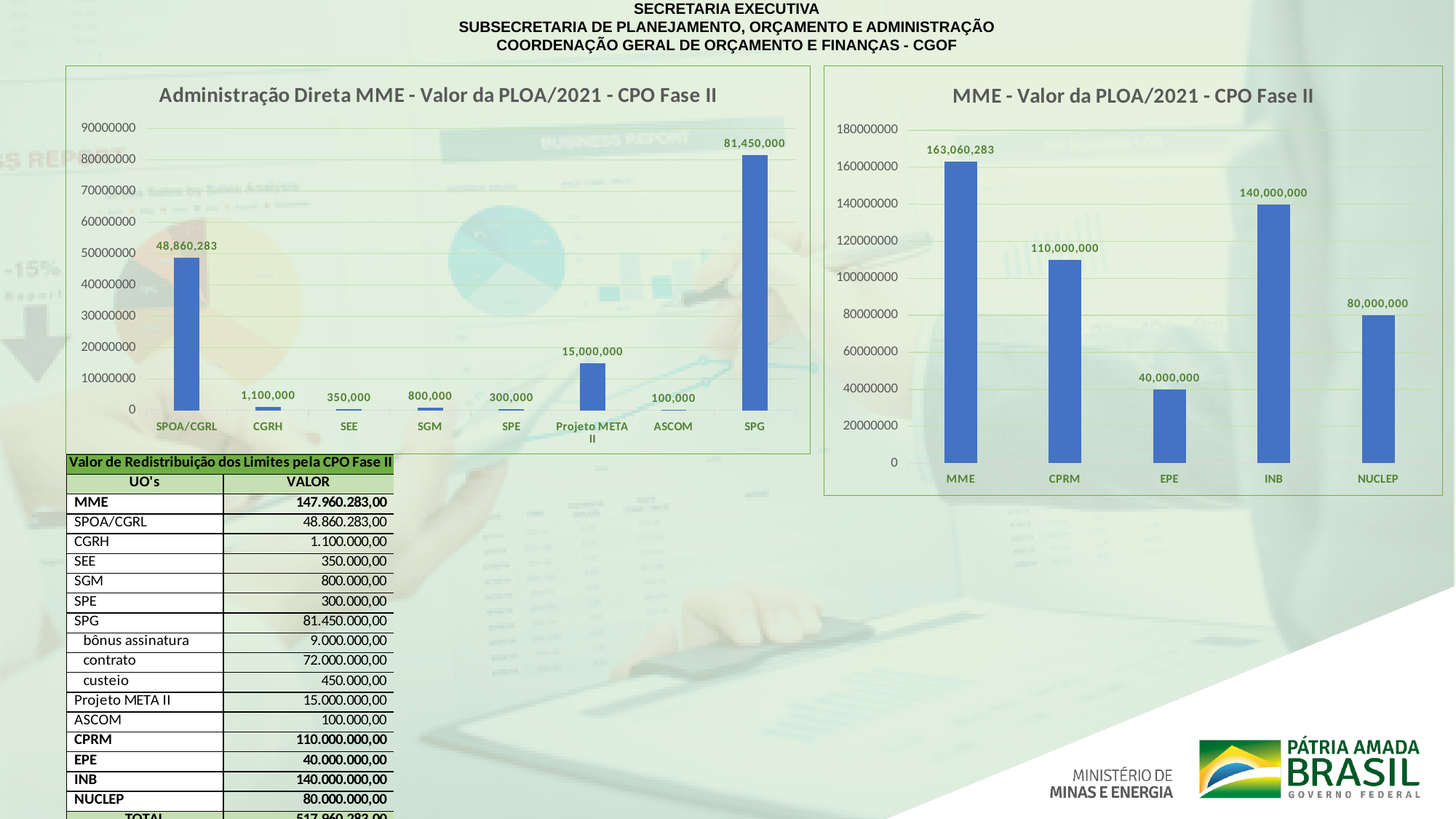
In the chart titled "Administração Direta MME - Valor da PLOA/2021 - CPO Fase II", how many categories are shown on the x axis? 8 In the chart titled "Administração Direta MME - Valor da PLOA/2021 - CPO Fase II", what is the value for SPOA/CGRL? 48,860,283 What type of chart is the chart titled "MME - Valor da PLOA/2021 - CPO Fase II"? Bar chart In the chart titled "Administração Direta MME - Valor da PLOA/2021 - CPO Fase II", which is larger, the value for CGRH or the value for SGM? CGRH In the chart titled "Administração Direta MME - Valor da PLOA/2021 - CPO Fase II", which category has the lowest value? ASCOM In the chart titled "Administração Direta MME - Valor da PLOA/2021 - CPO Fase II", which category has the highest value? SPG In the chart titled "Administração Direta MME - Valor da PLOA/2021 - CPO Fase II", what is the difference between the values for SPG and Projeto META II? 66,450,000 In the chart titled "MME - Valor da PLOA/2021 - CPO Fase II", what is the difference between the values for MME and CPRM? 53,060,283 In the chart titled "MME - Valor da PLOA/2021 - CPO Fase II", what is the value for INB? 140,000,000 In the chart titled "MME - Valor da PLOA/2021 - CPO Fase II", how many categories are shown on the x axis? 5 In the chart titled "MME - Valor da PLOA/2021 - CPO Fase II", which category has the highest value? MME In the chart titled "MME - Valor da PLOA/2021 - CPO Fase II", which category has the lowest value? EPE